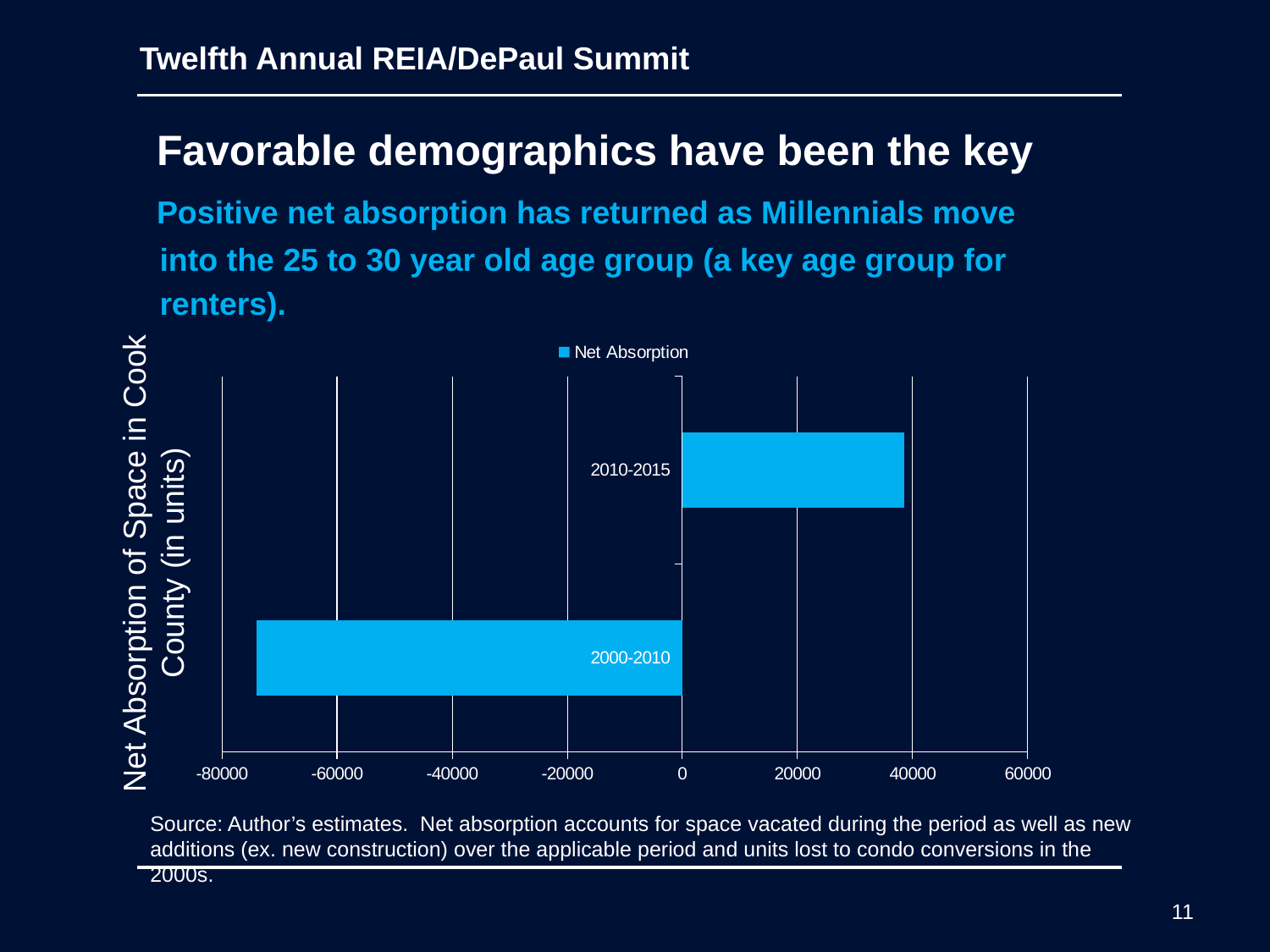
How many series does the chart legend list? 1 Is the net absorption for 2000-2010 greater or less than -60000? less Which period has the lowest net absorption? 2000-2010 Is the net absorption for 2010-2015 greater or less than 20000? greater Is the net absorption for 2000-2010 greater or less than -80000? greater How many periods (categories) are plotted in the chart? 2 Which period has the larger net absorption, 2000-2010 or 2010-2015? 2010-2015 Which period has the highest net absorption? 2010-2015 What kind of chart is shown on the slide? bar chart Did net absorption rise or fall from the 2000-2010 period to the 2010-2015 period? rise What is the name of the series shown in the chart legend? Net Absorption